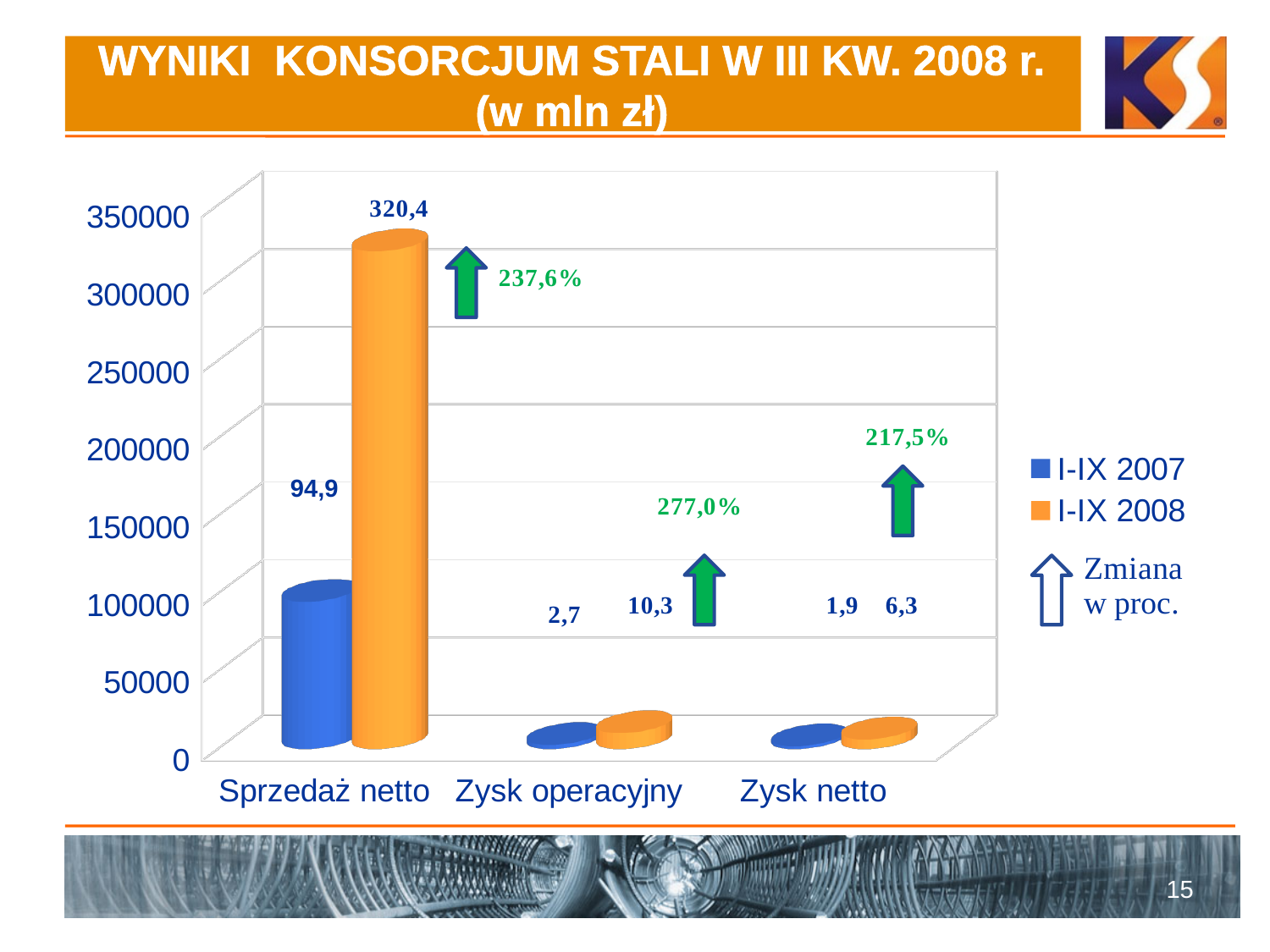
What is the value for Zysk netto in the I-IX 2007 series? 1,9 Which category has the lowest value in the I-IX 2007 series? Zysk netto What is the difference between the I-IX 2008 and I-IX 2007 values for Zysk netto? 4,4 What is the value for Zysk operacyjny in the I-IX 2008 series? 10,3 Which category has the highest value in the I-IX 2008 series? Sprzedaż netto How many data series does the legend list? 2 How many categories are shown on the x axis? 3 What is the value for Sprzedaż netto in the I-IX 2007 series? 94,9 What is the value for Sprzedaż netto in the I-IX 2008 series? 320,4 What is the difference between the I-IX 2008 and I-IX 2007 values for Sprzedaż netto? 225,5 What percentage change is shown for Zysk operacyjny? 277,0% Which is larger for Zysk operacyjny: the I-IX 2007 value or the I-IX 2008 value? I-IX 2008